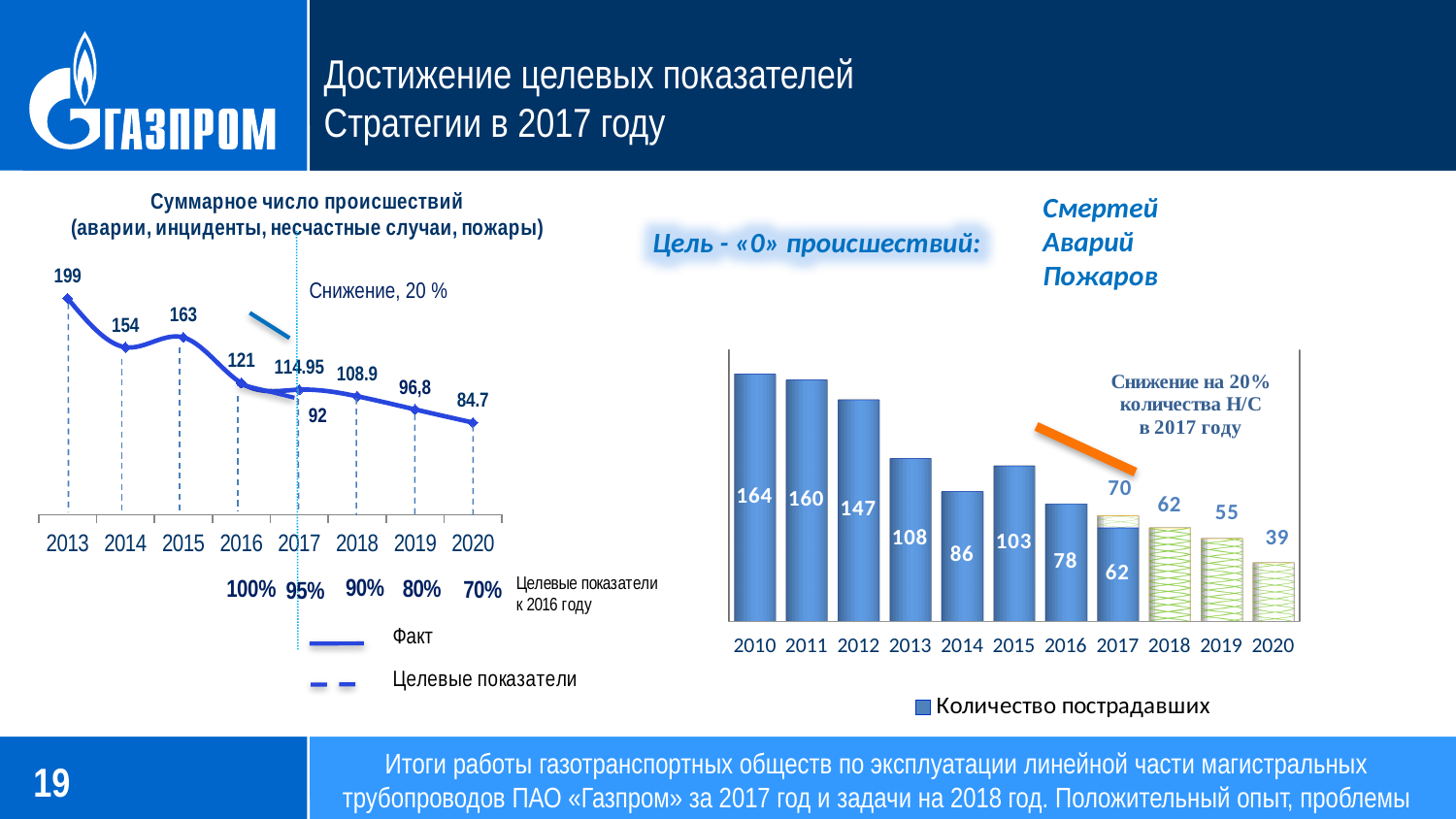
In the bar chart on the right (Количество пострадавших), which year has the highest value? 2010 In the line chart on the left (Суммарное число происшествий), which is larger, the value for 2014 or the value for 2015? 2015 In the bar chart on the right (Количество пострадавших), what is the value for 2014? 86 What kind of chart is the chart on the right (Количество пострадавших)? bar chart In the bar chart on the right (Количество пострадавших), what is the value for 2010? 164 In the bar chart on the right (Количество пострадавших), what is the difference between the values for 2010 and 2011? 4 In the line chart on the left (Суммарное число происшествий), what is the value for 2020? 84.7 In the line chart on the left (Суммарное число происшествий), what is the value for 2013? 199 In the bar chart on the right (Количество пострадавших), which year has the lowest value? 2020 What kind of chart is the chart on the left (Суммарное число происшествий)? line chart How many years are shown on the x axis of the bar chart on the right (Количество пострадавших)? 11 In the bar chart on the right (Количество пострадавших), which is larger, the value for 2014 or the value for 2015? 2015